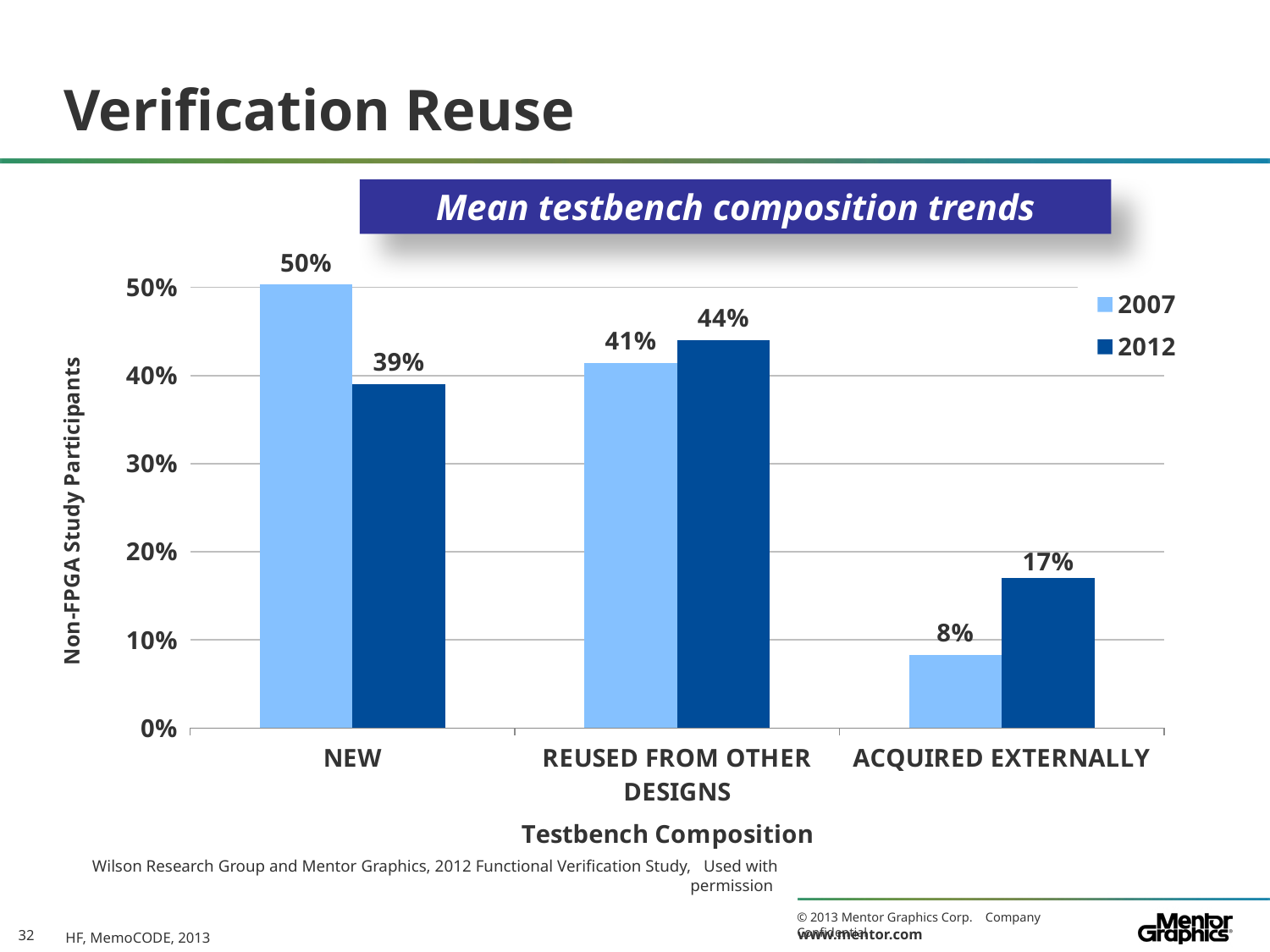
Which category has the lowest 2012 value? ACQUIRED EXTERNALLY What is the 2007 value for NEW? 50% How many categories are shown on the x axis? 3 What is the 2012 value for ACQUIRED EXTERNALLY? 17% Which is larger for REUSED FROM OTHER DESIGNS, the 2007 value or the 2012 value? 2012 What is the 2012 value for REUSED FROM OTHER DESIGNS? 44% How many series does the legend list? 2 What kind of chart is shown? bar chart What is the difference between the 2007 and 2012 values for NEW? 11% Which category has the highest 2007 value? NEW Is the 2007 value for ACQUIRED EXTERNALLY greater or less than 10%? less What is the title of the chart? Mean testbench composition trends